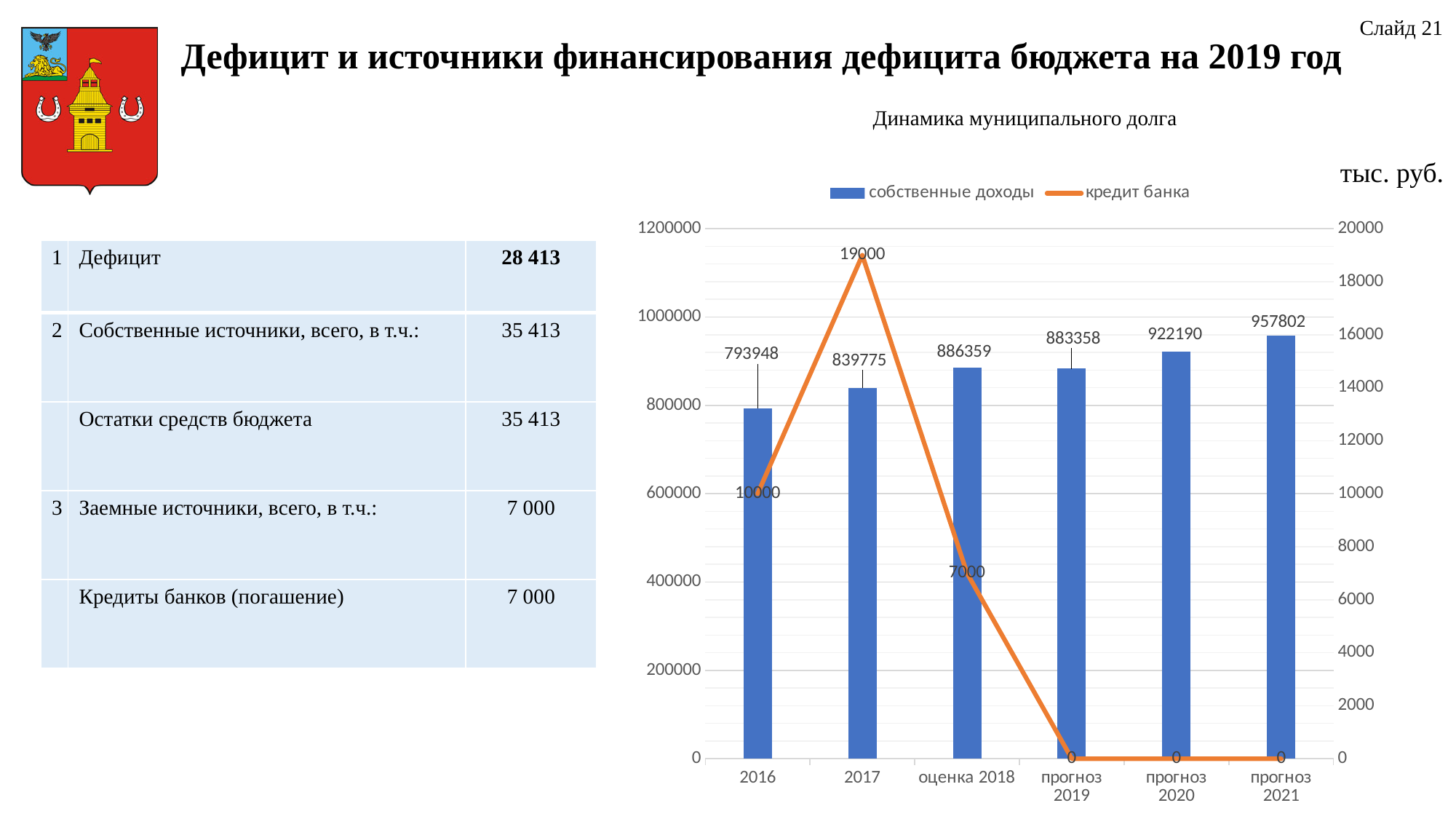
What is the value of кредит банка for оценка 2018? 7000 What is the value of собственные доходы for прогноз 2021? 957802 Which is larger, собственные доходы for оценка 2018 or for прогноз 2019? оценка 2018 Which category has the lowest value of собственные доходы? 2016 Which category has the highest value of собственные доходы? прогноз 2021 How many series does the legend list? 2 What is the value of кредит банка for 2017? 19000 How many categories are shown on the x axis? 6 What is the value of собственные доходы for 2016? 793948 What is the difference between собственные доходы for прогноз 2020 and оценка 2018? 35831 Which category has the highest value of кредит банка? 2017 What is the title of the chart? Динамика муниципального долга